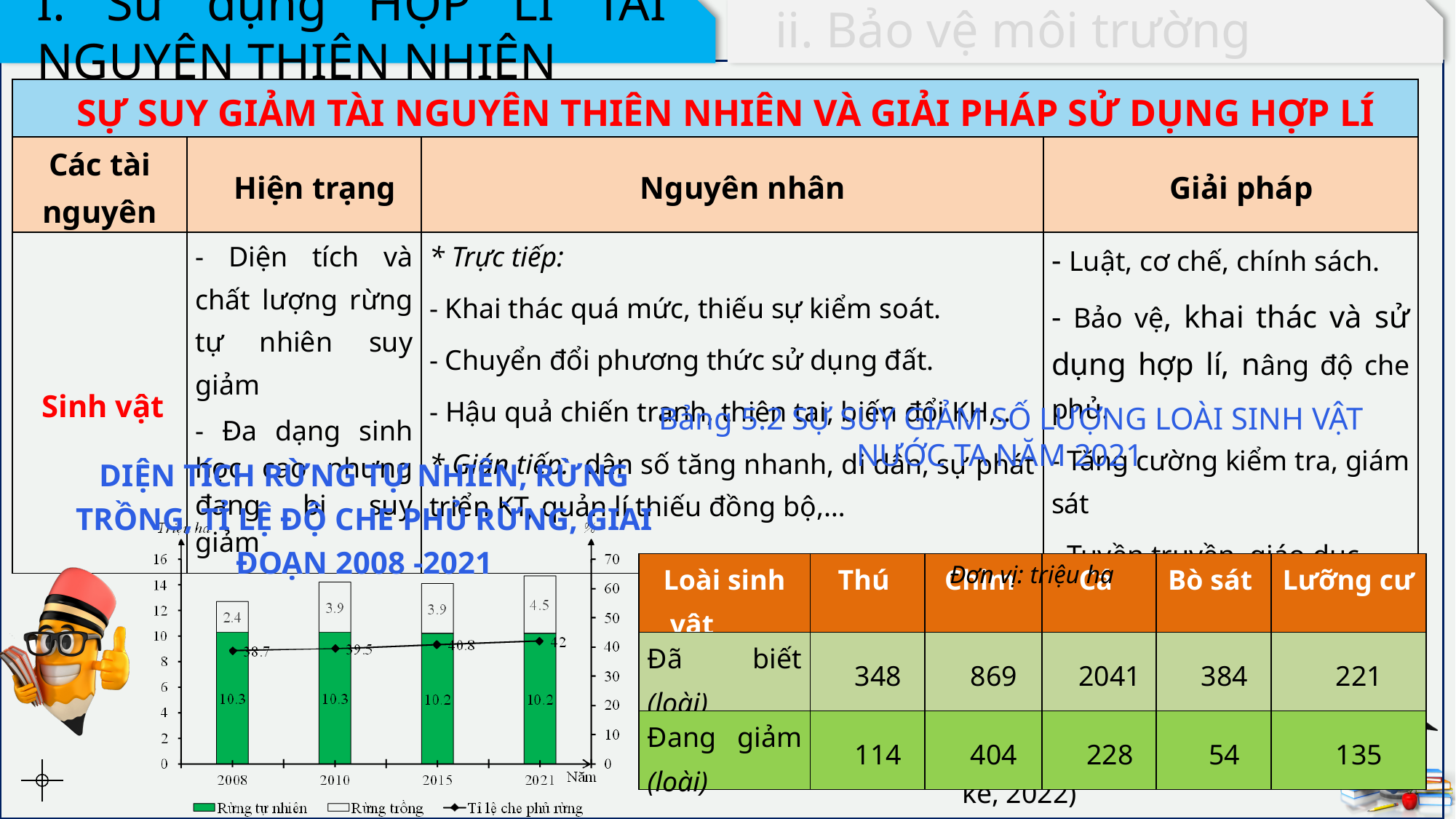
Does the Tỉ lệ che phủ rừng line rise or fall from 2008 to 2021? Rise What is the difference between the Rừng trồng values in 2021 and 2008? 2.1 Which is larger, the Rừng tự nhiên value in 2010 or in 2021? 2010 What kind of chart is shown on the slide? Stacked bar chart with a line How many years are shown on the x axis of the chart? 4 How many series does the chart legend list? 3 What is the total height of the stacked bar for 2021 (Rừng tự nhiên plus Rừng trồng)? 14.7 What is the Tỉ lệ che phủ rừng value in 2015? 40.8 In which year is the Rừng trồng value highest? 2021 In which year is the Rừng trồng value lowest? 2008 What is the value for Rừng tự nhiên in 2008? 10.3 What is the value for Rừng trồng in 2021? 4.5